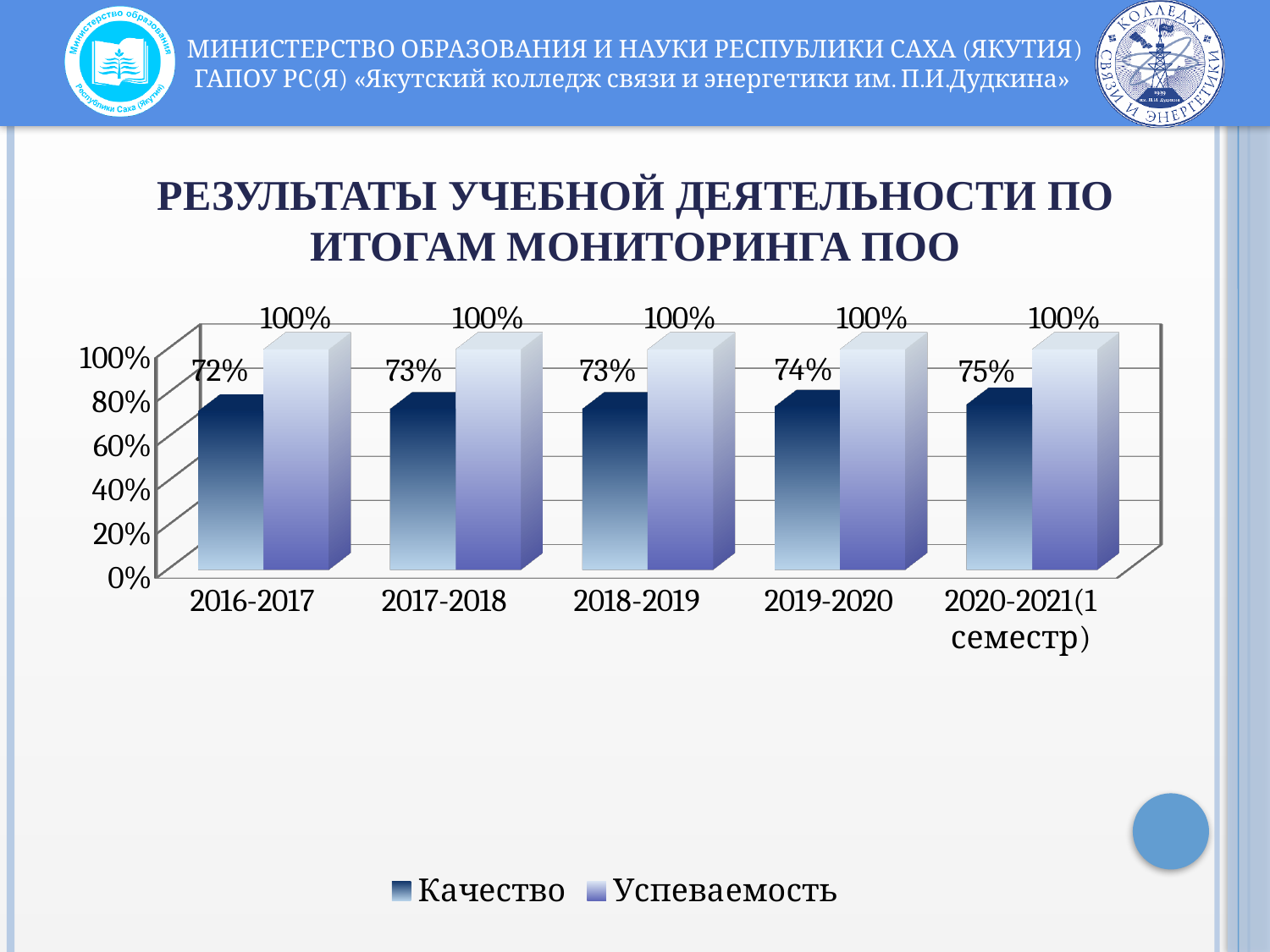
What is the difference between Успеваемость and Качество for 2017-2018? 27% What is the value of Качество for 2016-2017? 72% Which is larger for 2019-2020: Качество or Успеваемость? Успеваемость What kind of chart is shown on the slide? Bar chart Does the Качество value rise or fall from 2016-2017 to 2020-2021(1 семестр)? Rise How many periods are shown on the x axis? 5 Which period has the lowest Качество value? 2016-2017 How many series does the legend list? 2 Which period has the highest Качество value? 2020-2021(1 семестр) What is the value of Качество for 2019-2020? 74% What is the value of Успеваемость for 2018-2019? 100% What is the value of Качество for 2020-2021(1 семестр)? 75%